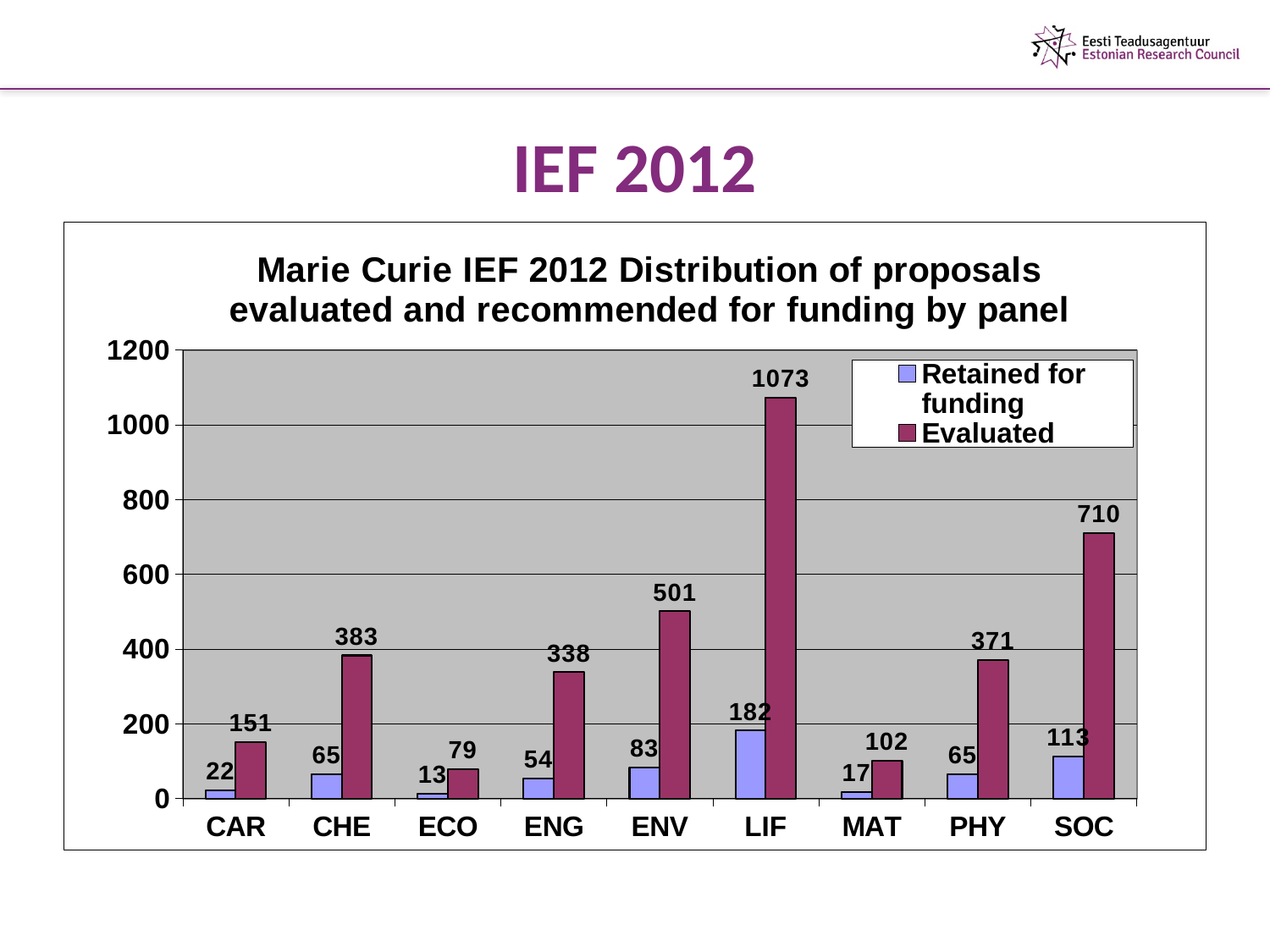
What is the title of the chart? Marie Curie IEF 2012 Distribution of proposals evaluated and recommended for funding by panel What kind of chart is shown? bar chart How many series does the legend list? 2 What is the Evaluated value for LIF? 1073 How many panels are shown on the x axis? 9 What is the difference between the Evaluated and Retained for funding values for CHE? 318 What is the Retained for funding value for ENV? 83 Which panel has the lowest Retained for funding value? ECO Which is larger, the Evaluated value for ENV or the Evaluated value for PHY? ENV Is the Evaluated value for SOC greater or less than 600? greater Which panel has the highest Evaluated value? LIF What is the Evaluated value for SOC? 710